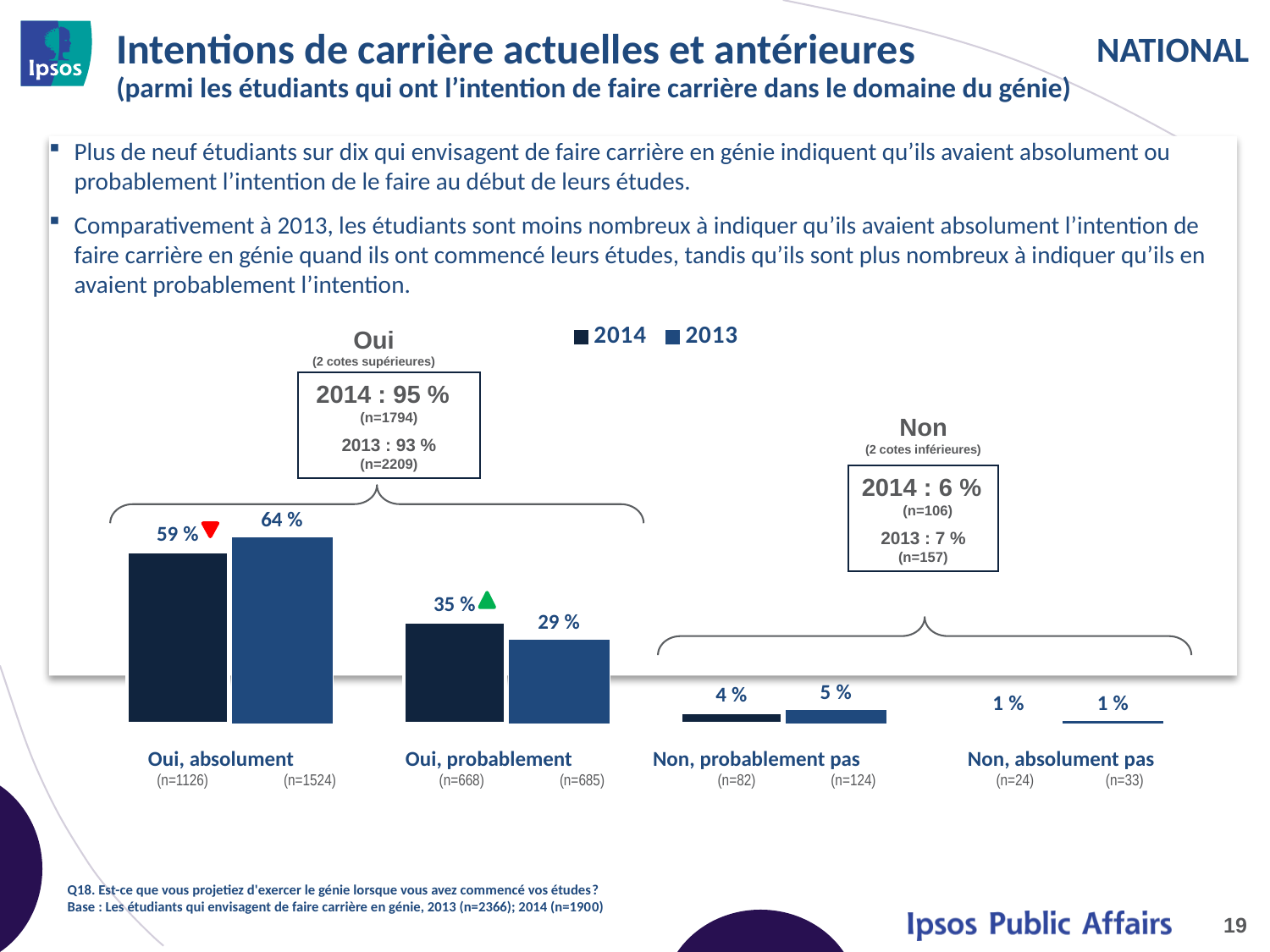
What kind of chart is shown on the slide? Bar chart What is the 2014 value for "Oui, absolument"? 59 % Which category has the highest 2014 value? Oui, absolument What is the difference between the 2013 and 2014 values for "Oui, absolument"? 5 % For "Oui, probablement", which year has the larger value, 2014 or 2013? 2014 Which category has the lowest 2013 value? Non, absolument pas What is the difference between the 2014 and 2013 values for "Oui, probablement"? 6 % Which two years are listed in the chart legend? 2014 and 2013 What is the 2013 value for "Oui, probablement"? 29 % How many categories are shown on the x axis of the chart? 4 How many series does the chart legend list? 2 What is the 2013 value for "Non, probablement pas"? 5 %